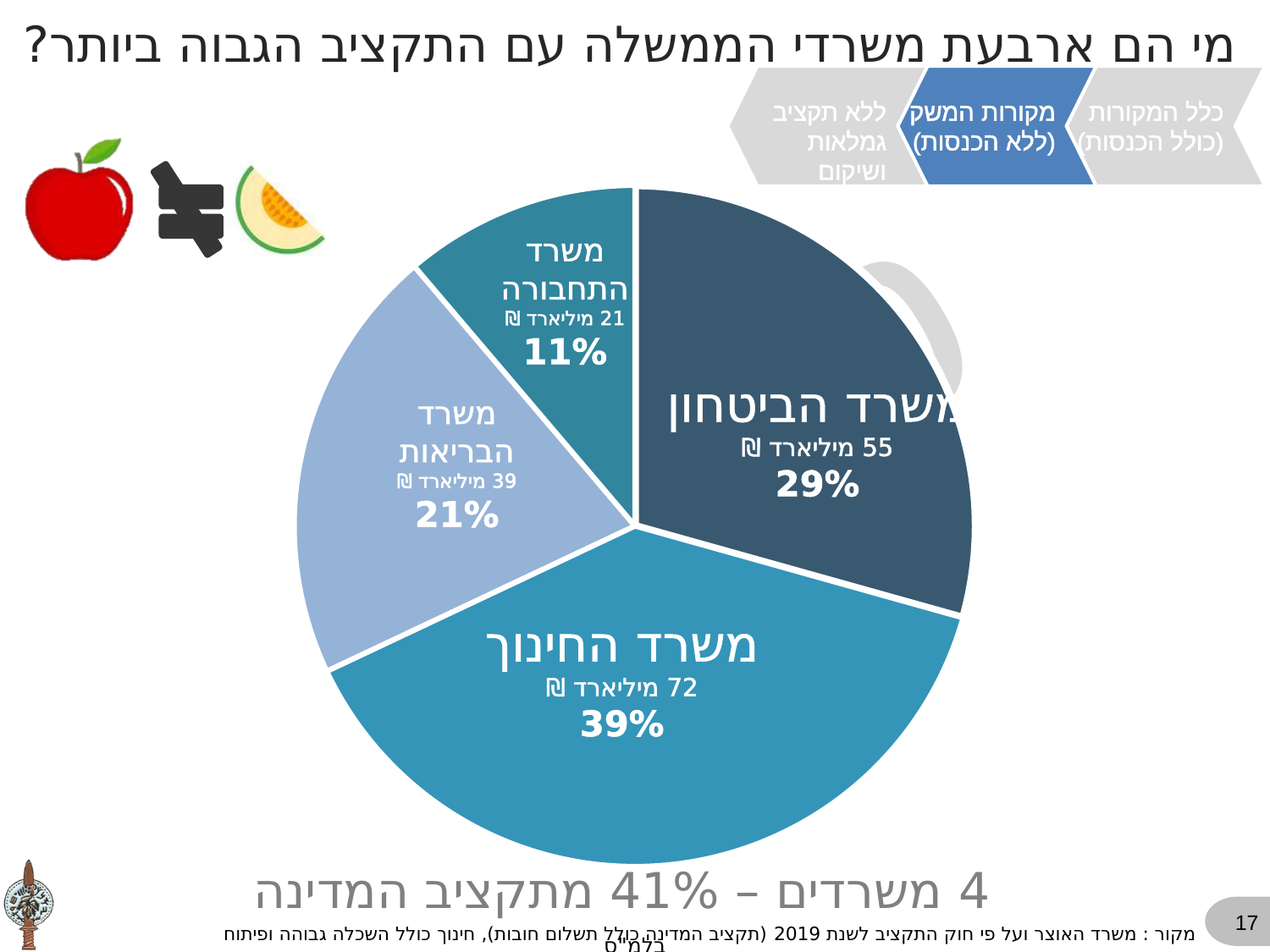
What is the budget value shown for משרד הבריאות? 39 מיליארד ₪ Which has a larger budget, משרד הבריאות or משרד התחבורה? משרד הבריאות What is the budget value shown for משרד הביטחון? 55 מיליארד ₪ Which ministry has the largest slice of the pie? משרד החינוך What is the title of the slide containing the pie chart? מי הם ארבעת משרדי הממשלה עם התקציב הגבוה ביותר? What percentage of the pie is משרד התחבורה? 11% What percentage of the pie is משרד החינוך? 39% What percentage of the pie is משרד הביטחון? 29% How many slices does the pie chart have? 4 What kind of chart is shown on the slide? pie chart What is the difference in billions of ₪ between משרד החינוך and משרד הביטחון? 17 מיליארד ₪ Which ministry has the smallest slice of the pie? משרד התחבורה